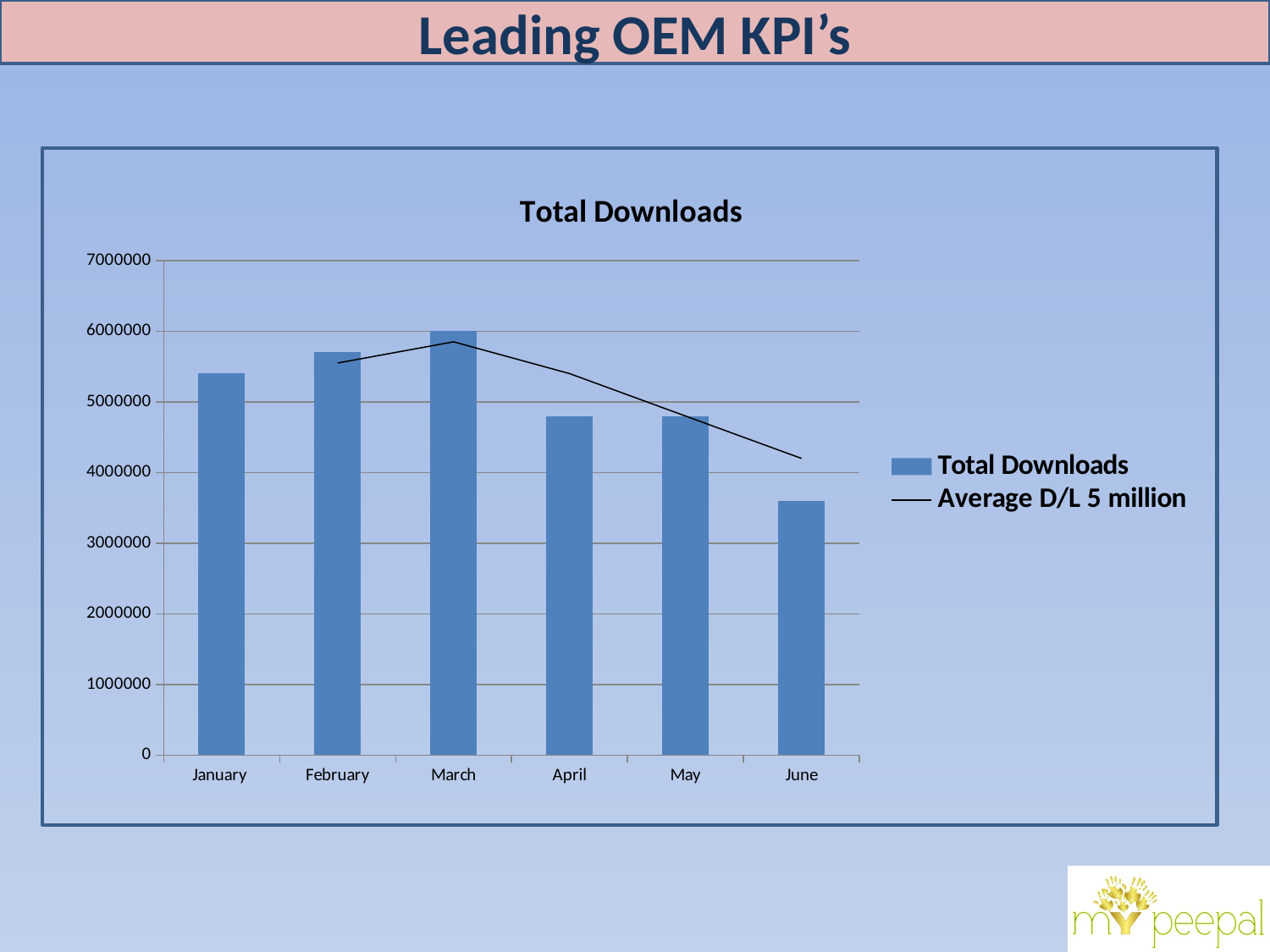
How many months are shown on the x axis of the chart? 6 What is the name of the line series in the chart legend? Average D/L 5 million What is the title of the chart? Total Downloads Which month has the highest Total Downloads? March How many series does the chart legend list? 2 Is the value for Total Downloads in January greater or less than 5000000? greater What kind of chart is shown on the slide? bar chart Which month has the lowest Total Downloads? June Is the value for Total Downloads in April greater or less than 5000000? less Is the value for Total Downloads in June greater or less than 4000000? less Do Total Downloads rise or fall from March to June? fall Which month has more Total Downloads, February or June? February